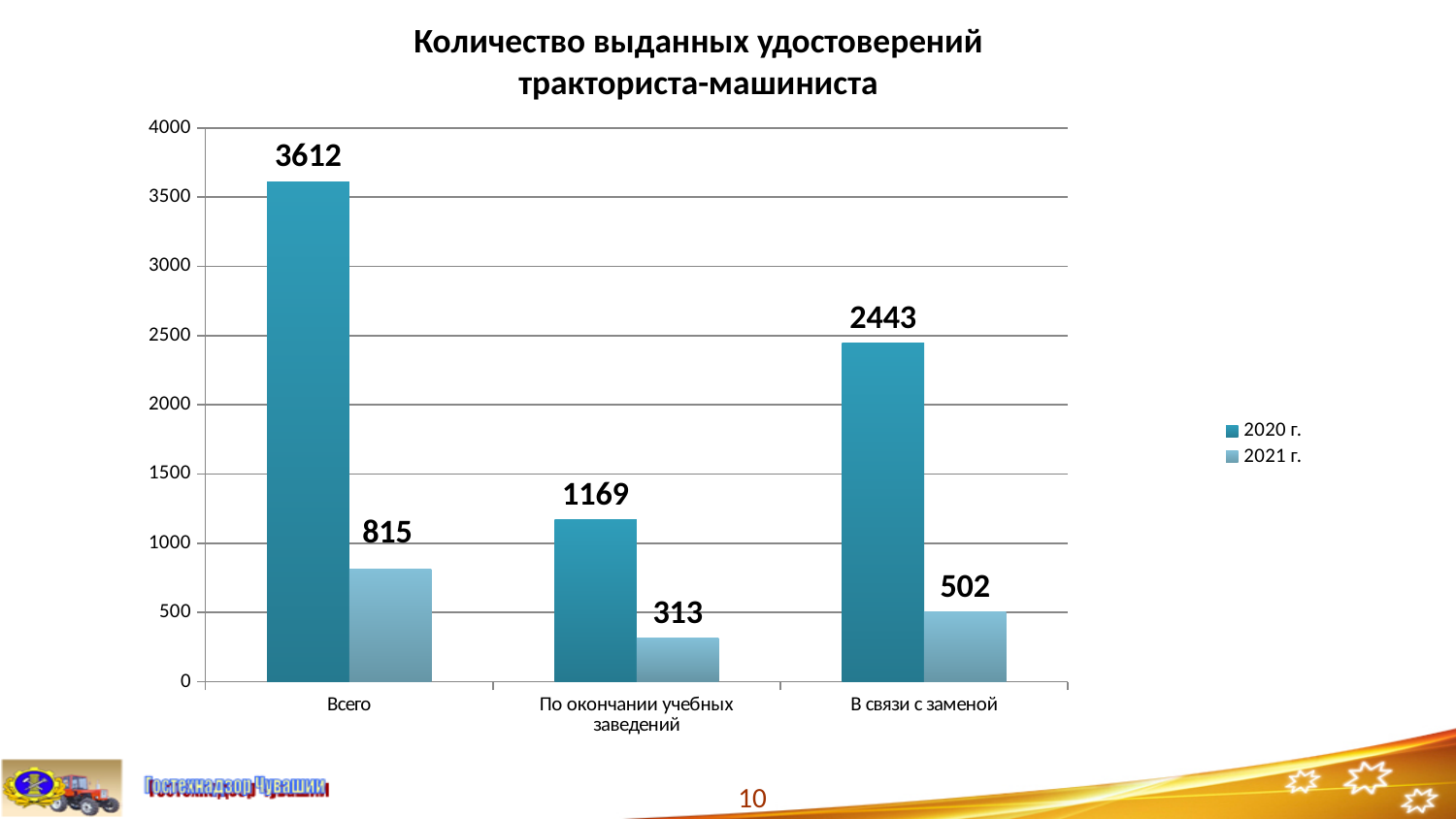
Which category has the lowest value for 2021 г.? По окончании учебных заведений What kind of chart is shown on the slide? Bar chart What is the title of the chart? Количество выданных удостоверений тракториста-машиниста What is the difference between the 2020 г. and 2021 г. values in the Всего category? 2797 What is the difference between the 2020 г. values for В связи с заменой and По окончании учебных заведений? 1274 What is the value for 2020 г. in the Всего category? 3612 Which category has the highest value for 2020 г.? Всего How many categories are shown on the x axis? 3 Which is larger: the 2021 г. value for Всего or the 2020 г. value for По окончании учебных заведений? 2020 г. value for По окончании учебных заведений How many series does the legend list? 2 What is the value for 2021 г. in the В связи с заменой category? 502 What is the value for 2021 г. in the По окончании учебных заведений category? 313